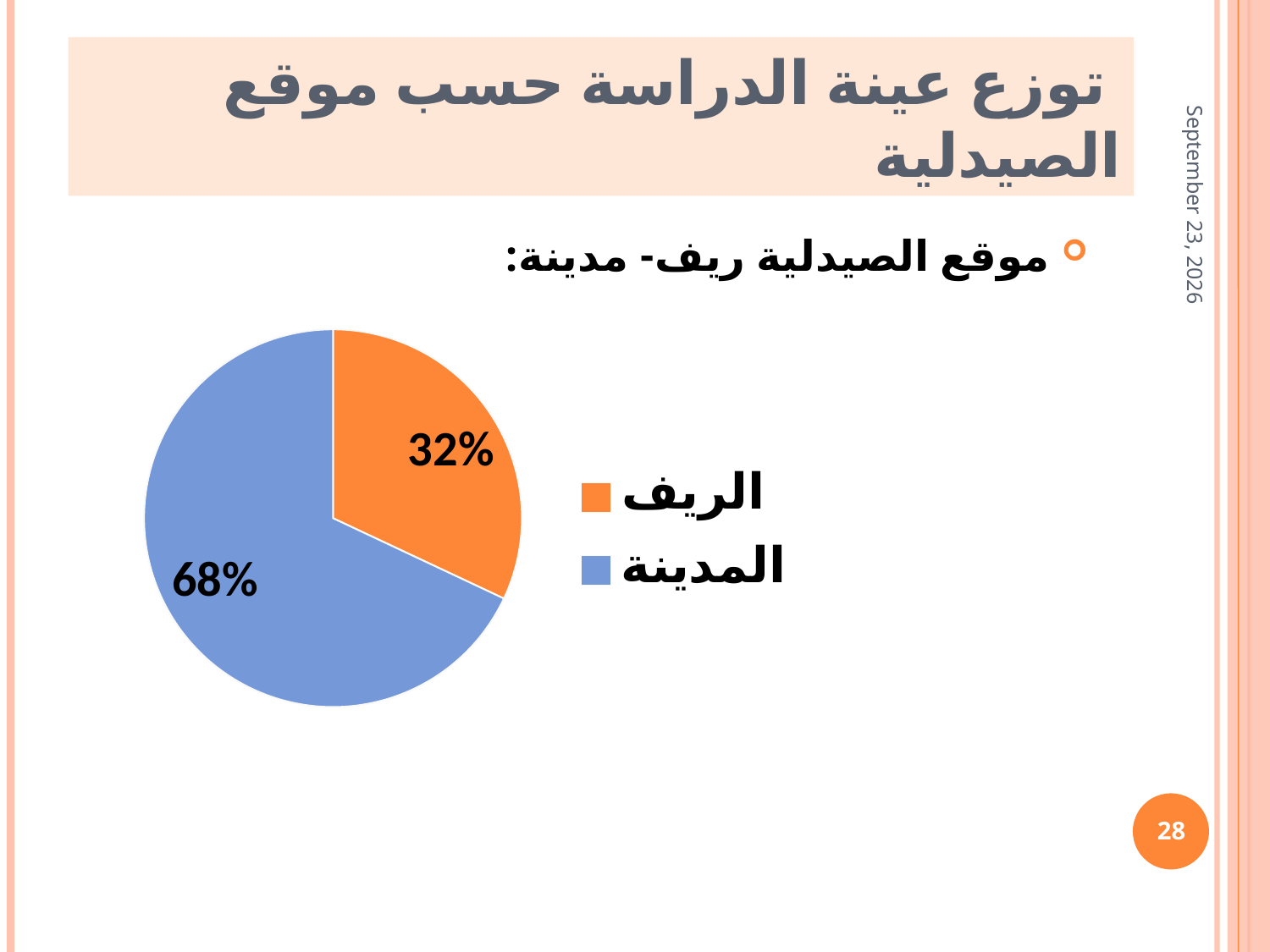
What share of the pie does المدينة represent? 68% What is the difference in percentage points between المدينة and الريف? 36 What percentage of the pie is labelled for المدينة? 68% What kind of chart is shown on the slide? pie chart Which category has the largest share of the pie? المدينة What colour is the slice for المدينة? blue How many entries does the legend list? 2 What colour is the slice for الريف? orange What percentage of the pie is labelled for الريف? 32% Which is larger, the share for الريف or the share for المدينة? المدينة Which category has the smallest share of the pie? الريف How many slices does the pie chart have? 2